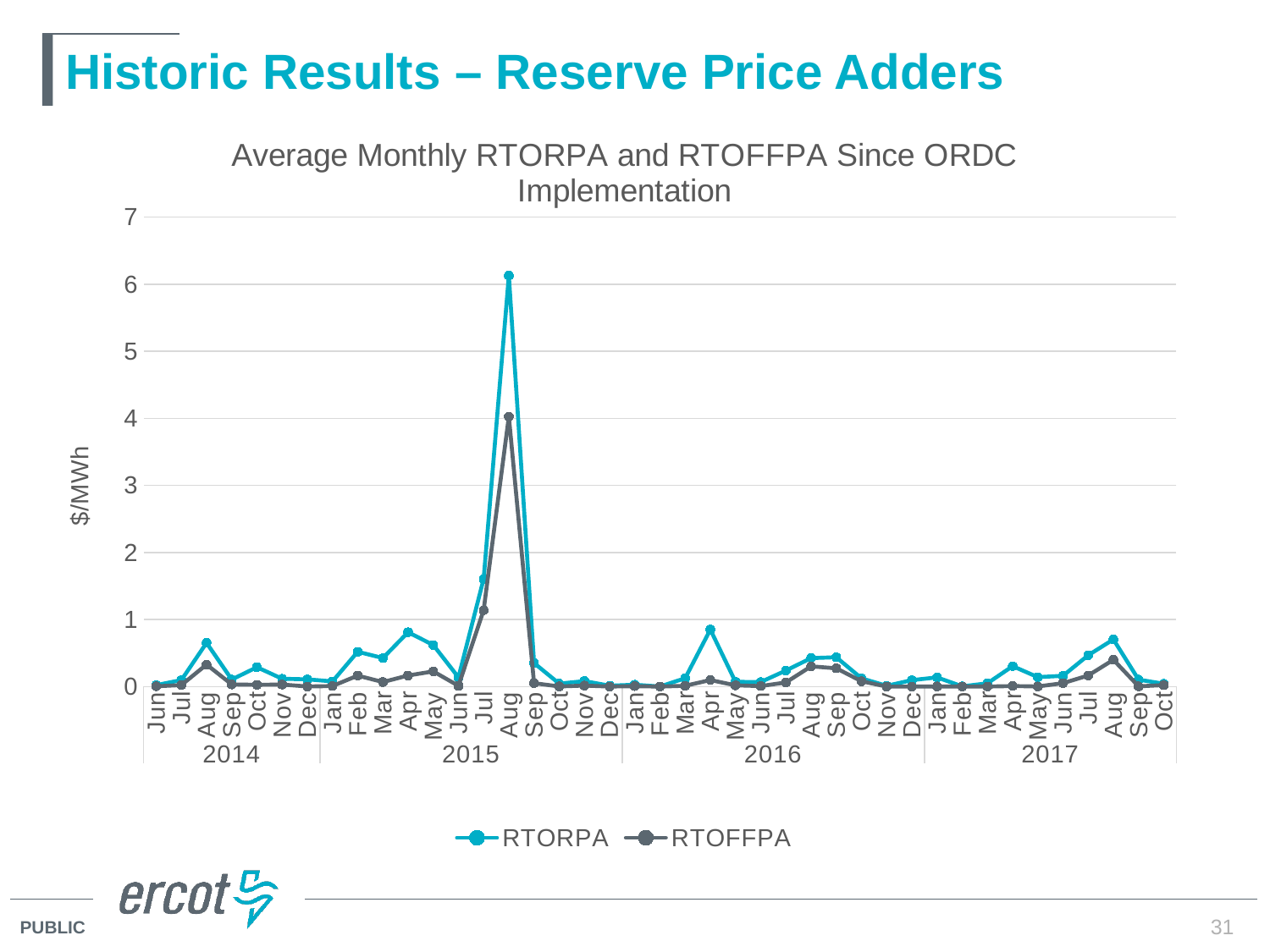
How many series does the legend list? 2 In which month and year does the RTORPA series reach its highest value? Aug 2015 How many monthly data points are plotted for each series? 41 What is the label on the vertical axis? $/MWh What is the title of the chart? Average Monthly RTORPA and RTOFFPA Since ORDC Implementation How many years are labeled along the horizontal axis? 4 In Aug 2015, which series has the larger value, RTORPA or RTOFFPA? RTORPA Is the RTORPA value for Aug 2015 greater or less than 5? greater What kind of chart is shown on the slide? line chart Is the RTORPA value for Apr 2016 greater or less than 1? less Is the RTOFFPA value for Aug 2015 greater or less than 3? greater In which month and year does the RTOFFPA series reach its highest value? Aug 2015